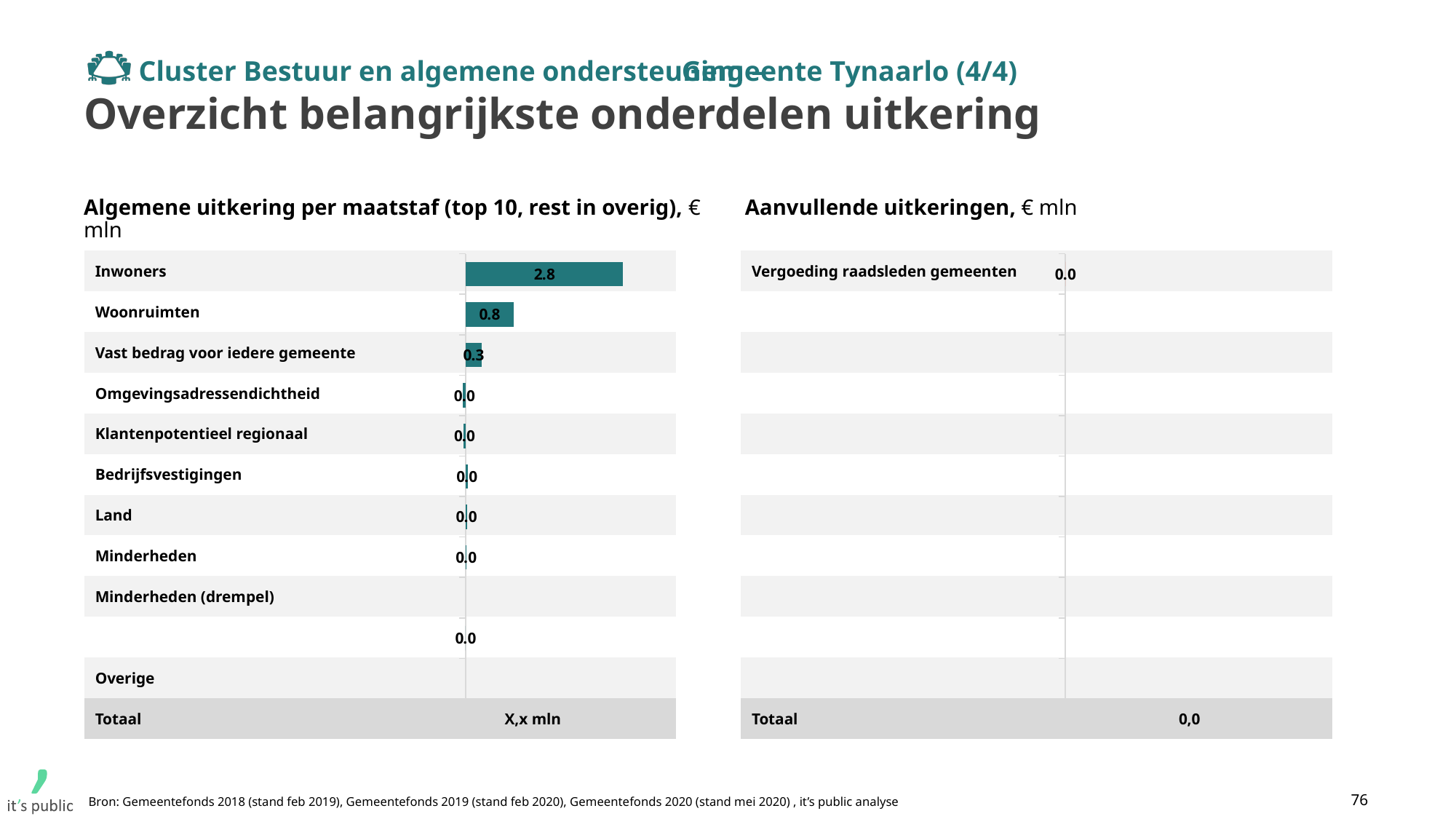
What kind of chart is 'Algemene uitkering per maatstaf'? Bar chart In the chart 'Algemene uitkering per maatstaf', which is larger: Woonruimten or Vast bedrag voor iedere gemeente? Woonruimten In the chart 'Algemene uitkering per maatstaf', what is the value for Vast bedrag voor iedere gemeente? 0.3 In the chart 'Algemene uitkering per maatstaf', what is the difference between the values for Inwoners and Woonruimten? 2.0 In the chart 'Aanvullende uitkeringen', what is the value for Vergoeding raadsleden gemeenten? 0.0 In the chart 'Aanvullende uitkeringen', what is the Totaal shown? 0,0 In the chart 'Algemene uitkering per maatstaf', what is the value for Inwoners? 2.8 What unit is stated in the title of the chart 'Aanvullende uitkeringen'? € mln In the chart 'Algemene uitkering per maatstaf', what is the value for Woonruimten? 0.8 In the chart 'Algemene uitkering per maatstaf', which category has the highest value? Inwoners In the chart 'Algemene uitkering per maatstaf', what is the value for Land? 0.0 In the chart 'Algemene uitkering per maatstaf', what is the difference between the values for Woonruimten and Vast bedrag voor iedere gemeente? 0.5